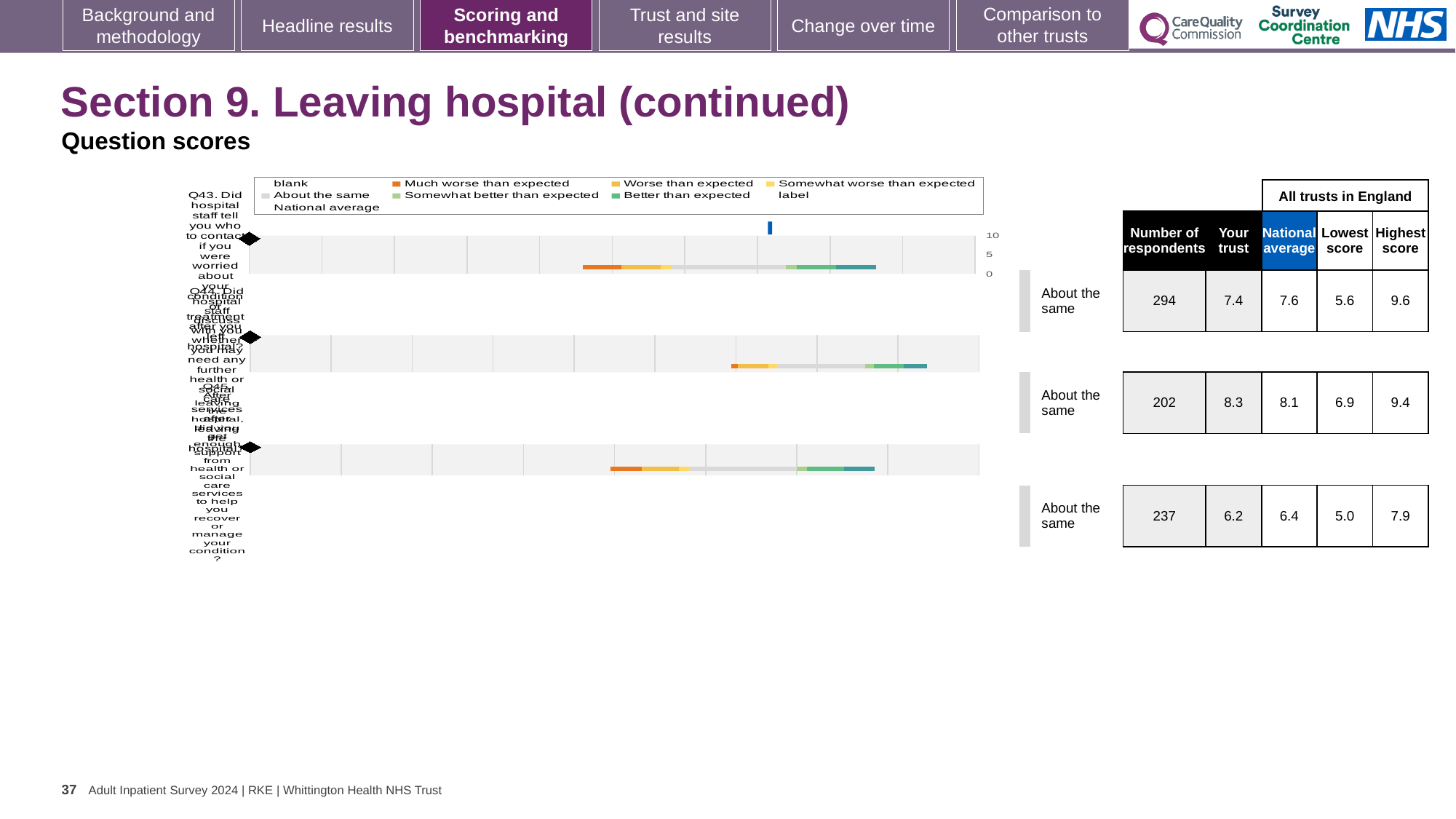
How many questions (rows) are plotted in the chart? 3 According to the table next to the chart, what is the national average score for Q44? 8.1 For Q43, which is larger: the 'Your trust' score or the national average? National average According to the table next to the chart, what is the highest score among all trusts in England for Q43? 9.6 According to the table next to the chart, how many respondents answered Q45? 237 Which question has the highest 'Your trust' score in the table? Q44 For Q44, what is the difference between the highest score and the lowest score among all trusts in England? 2.5 Which question has the lowest 'Your trust' score in the table? Q45 According to the table next to the chart, what is the 'Your trust' score for Q43? 7.4 What benchmark category is shown for all three questions on the slide? About the same What kind of chart is shown on the slide? bar chart What is the subtitle shown under the slide title? Question scores